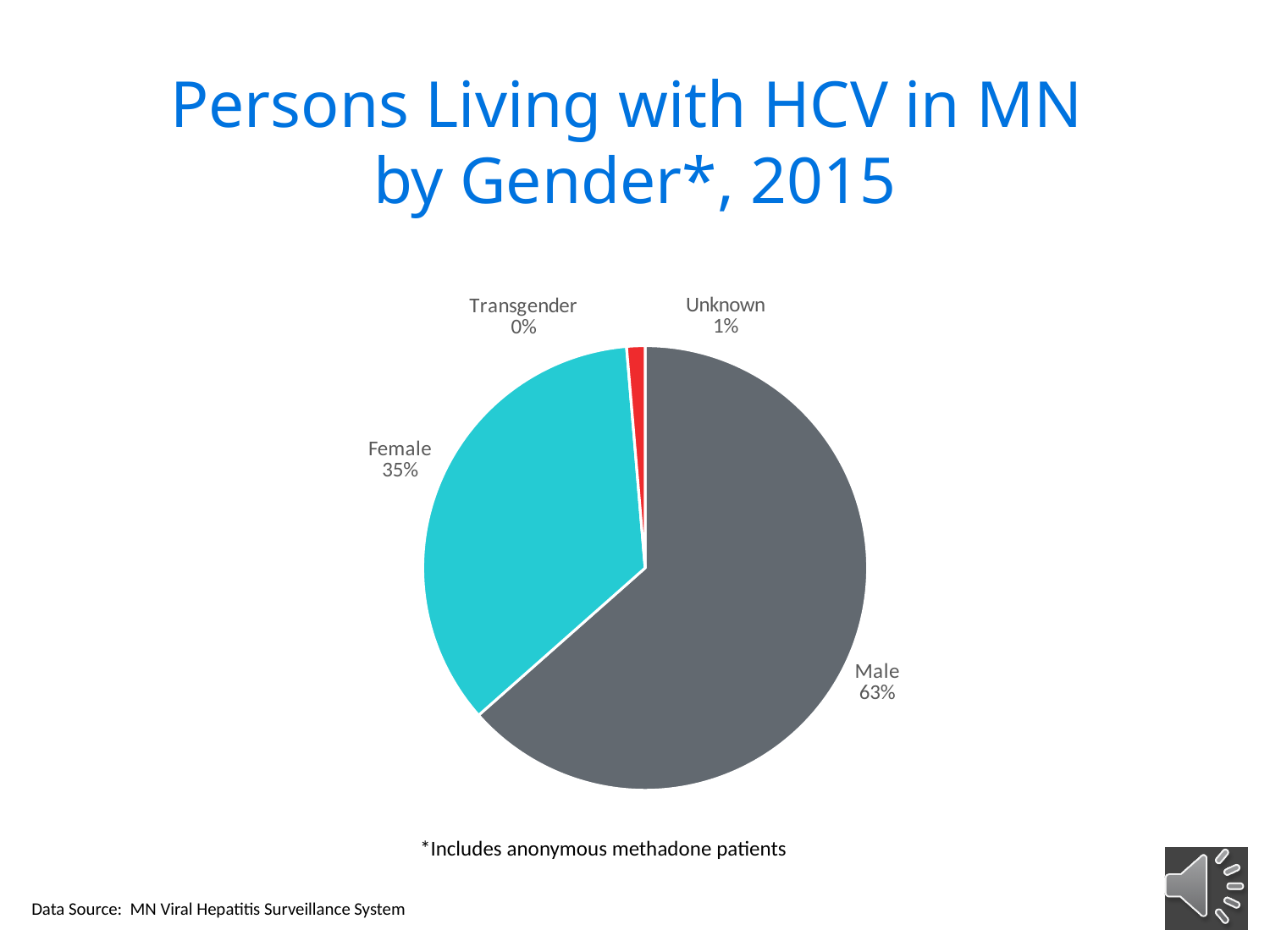
What share of persons living with HCV in MN in 2015 are Male? 63% Which gender category has the smallest share of the pie? Transgender What share of persons living with HCV in MN in 2015 are Female? 35% What kind of chart is shown on the slide? Pie chart How many categories are shown in the pie chart? 4 What is the difference in percentage points between the Male and Female shares? 28 What data source is cited on the slide? MN Viral Hepatitis Surveillance System What percentage is shown for the Unknown slice? 1% Which gender category has the largest share of the pie? Male What is the title of the chart? Persons Living with HCV in MN by Gender*, 2015 Which is larger, the Female share or the Unknown share? Female What percentage is shown for the Transgender slice? 0%